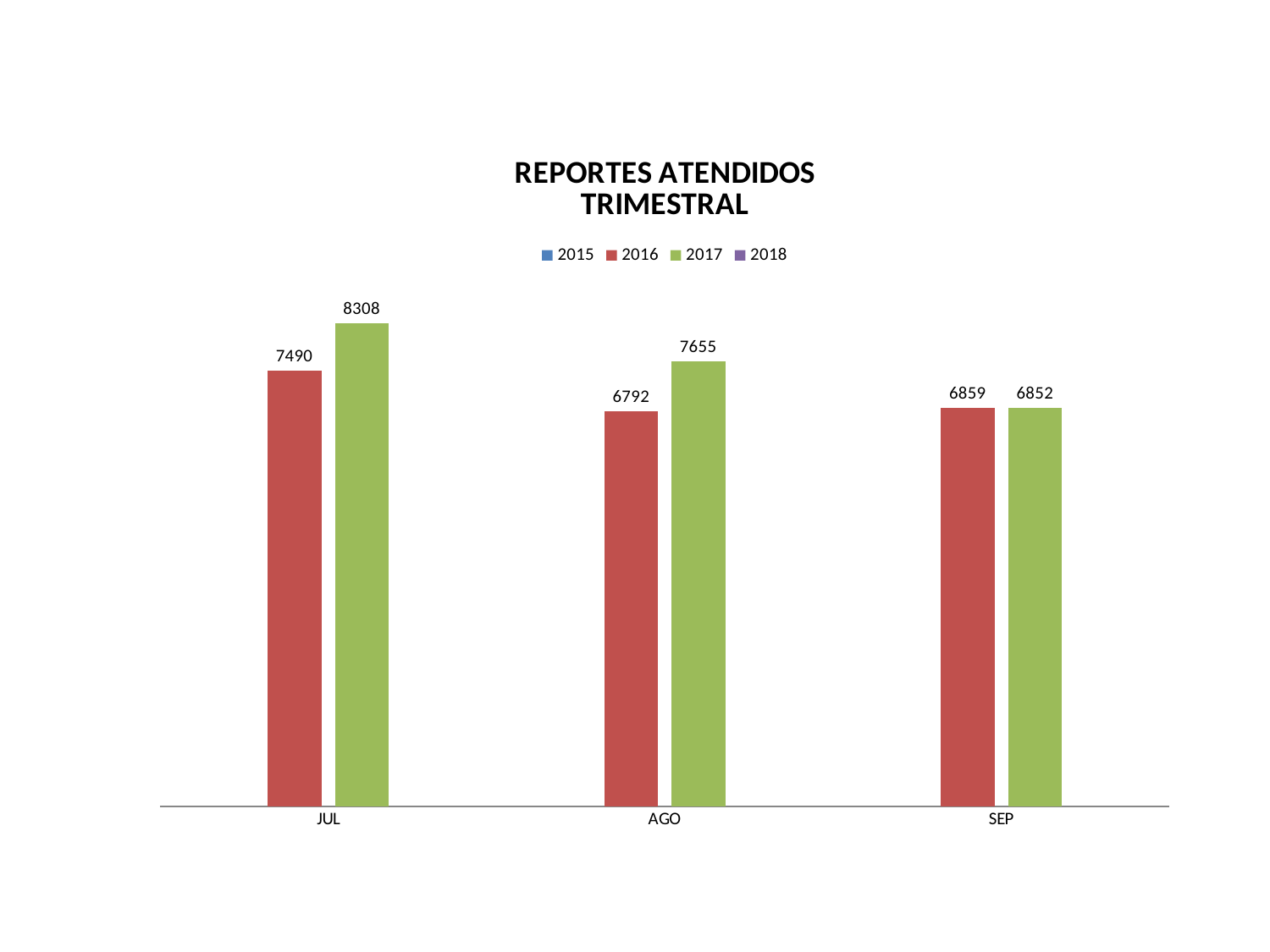
What is the value for 2017 in JUL? 8308 What is the value for 2016 in AGO? 6792 What is the difference between the 2017 and 2016 values in JUL? 818 How many series does the legend list? 4 Which month has the highest value for 2017? JUL What kind of chart is shown on the slide? Bar chart Which is larger in JUL, the 2016 value or the 2017 value? 2017 What is the difference between the 2017 and 2016 values in AGO? 863 What is the value for 2016 in SEP? 6859 What is the value for 2017 in AGO? 7655 Which month has the lowest value for 2016? AGO How many months are shown on the x axis? 3